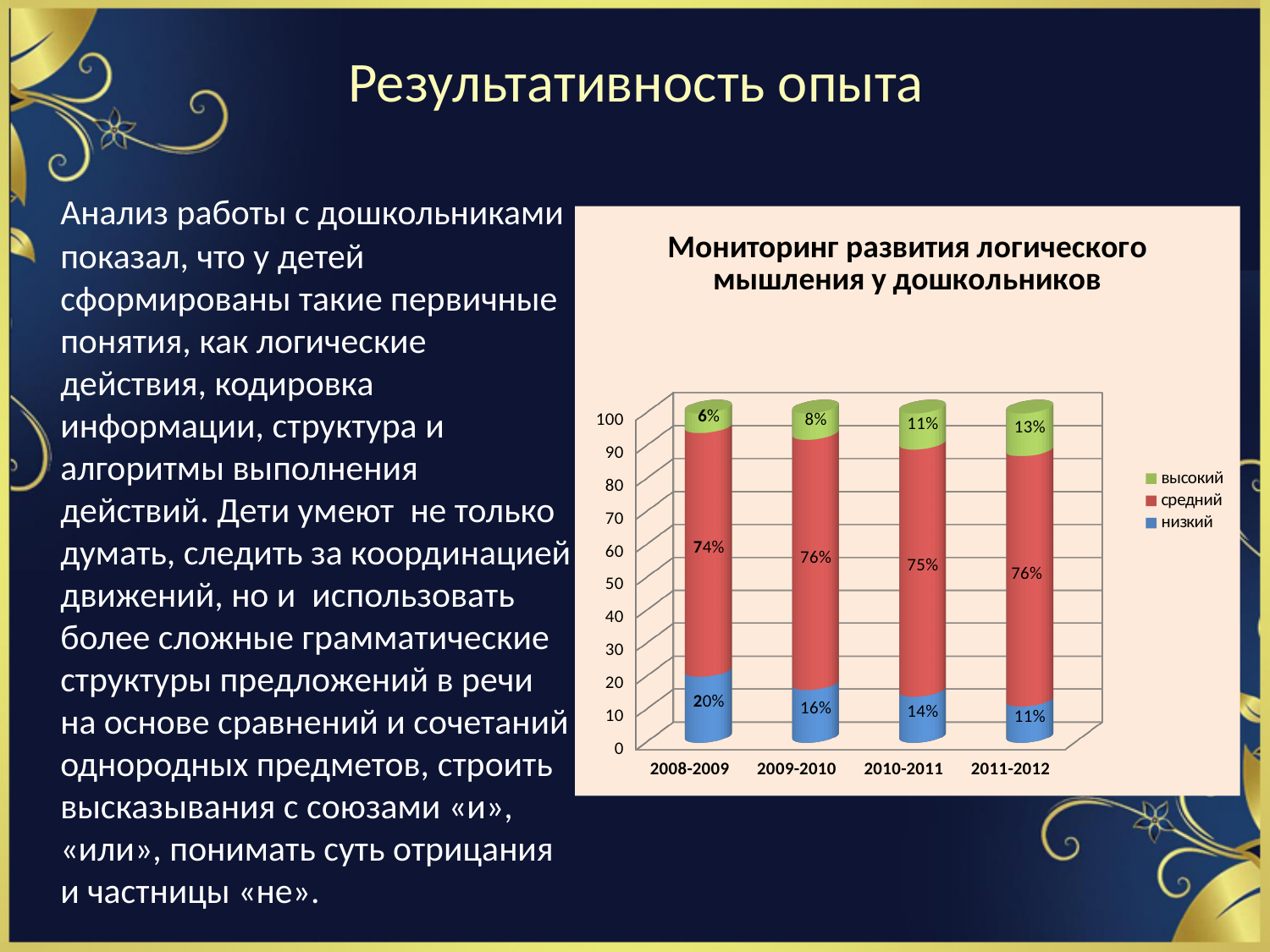
What is the value for низкий in 2009-2010? 16% Does the value for высокий rise or fall from 2008-2009 to 2011-2012? rise What is the value for средний in 2010-2011? 75% How many series does the legend list? 3 What is the difference between the низкий values for 2008-2009 and 2011-2012? 9% What kind of chart is shown? stacked bar chart How many year categories are shown on the x axis? 4 What is the value for низкий in 2008-2009? 20% Which is larger: высокий in 2010-2011 or высокий in 2009-2010? высокий in 2010-2011 In which year is the value for низкий the lowest? 2011-2012 What is the value for высокий in 2011-2012? 13% In which year is the value for высокий the highest? 2011-2012